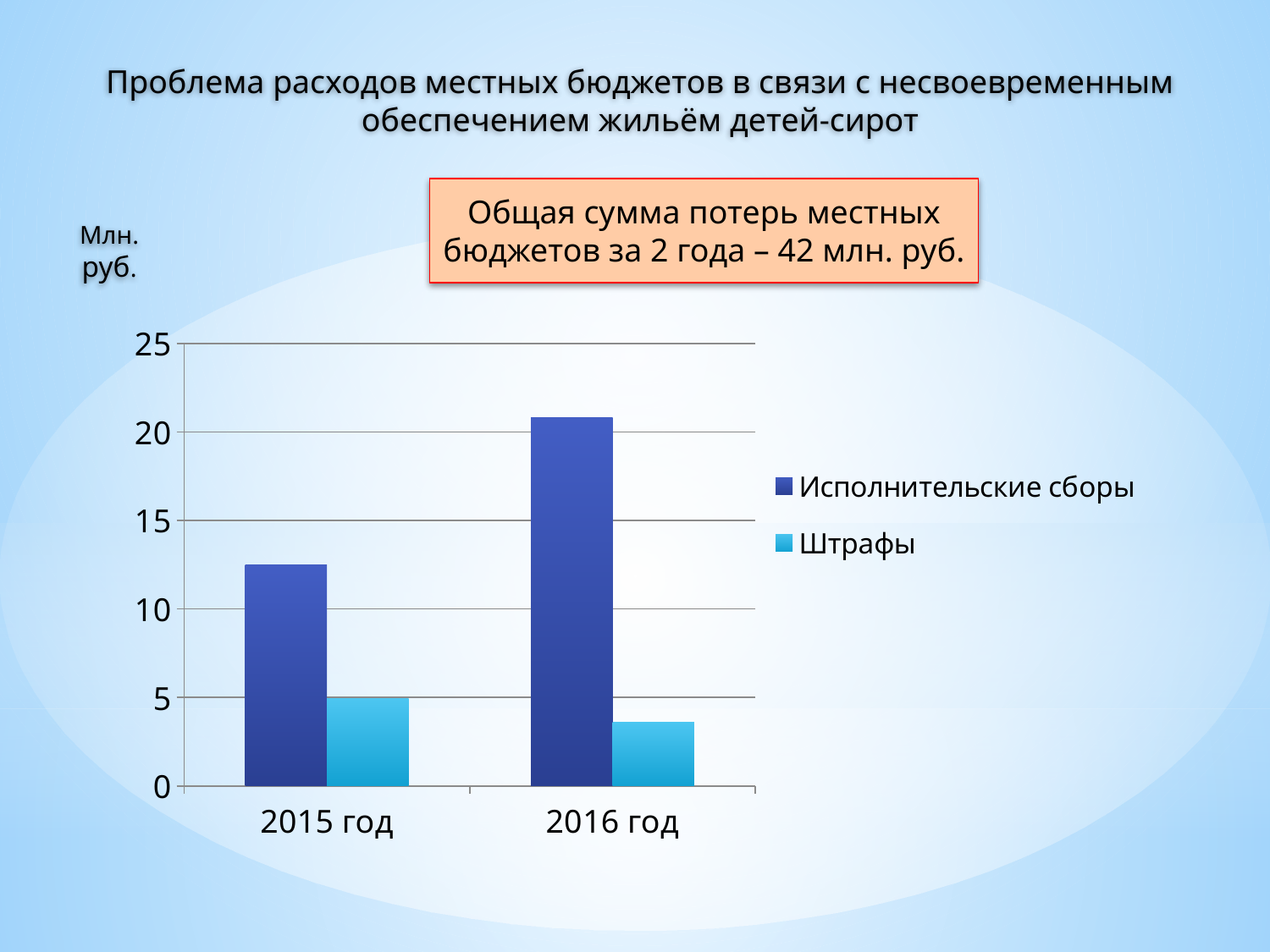
What kind of chart is shown on the slide? bar chart Is the value for Исполнительские сборы in 2016 год greater or less than 20? greater Do the values for Исполнительские сборы rise or fall from 2015 год to 2016 год? rise Is the value for Штрафы in 2016 год greater or less than 5? less Which year has the larger value for Штрафы, 2015 год or 2016 год? 2015 год Which bar is the highest on the chart? Исполнительские сборы, 2016 год Is the value for Исполнительские сборы in 2015 год greater or less than 10? greater How many categories (years) are shown on the x axis? 2 Which bar is the lowest on the chart? Штрафы, 2016 год Which year has the larger value for Исполнительские сборы, 2015 год or 2016 год? 2016 год What unit is indicated for the vertical axis of the chart? Млн. руб. How many series does the legend list? 2